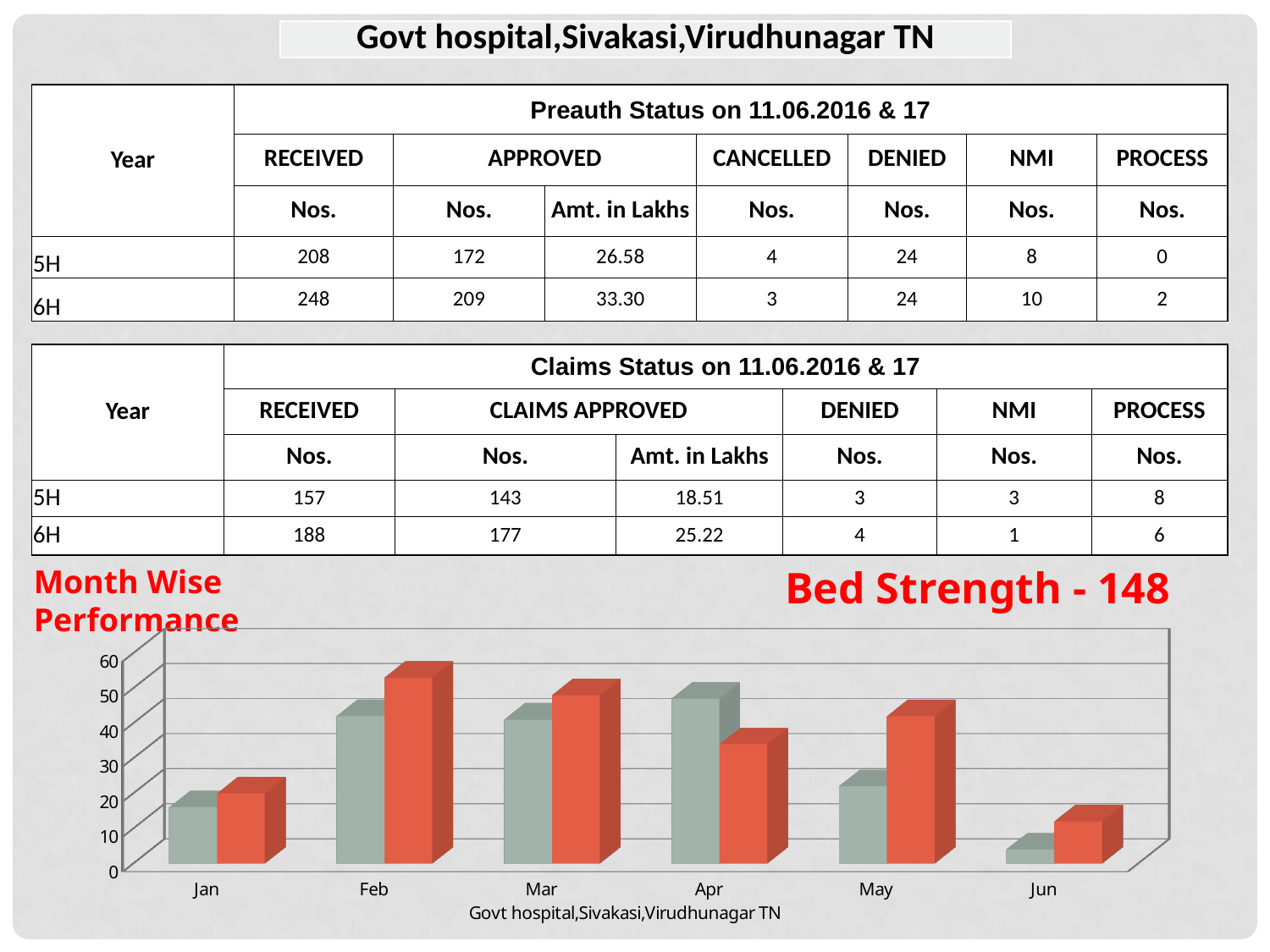
What text appears below the month labels on the chart's x axis? Govt hospital,Sivakasi,Virudhunagar TN What kind of chart is shown at the bottom of the slide? bar chart In Apr, which bar is taller, the grey bar or the red bar? the grey bar In which month is the grey bar the shortest? Jun Is the value of the grey bar for Jun greater or less than 10? less In which month is the red bar the shortest? Jun Do the grey bars rise or fall from Apr to Jun? fall In May, which bar is taller, the grey bar or the red bar? the red bar In which month is the grey bar the tallest? Apr Is the value of the red bar for Mar greater or less than 40? greater In which month is the red bar the tallest? Feb How many months are shown on the x axis of the chart? 6